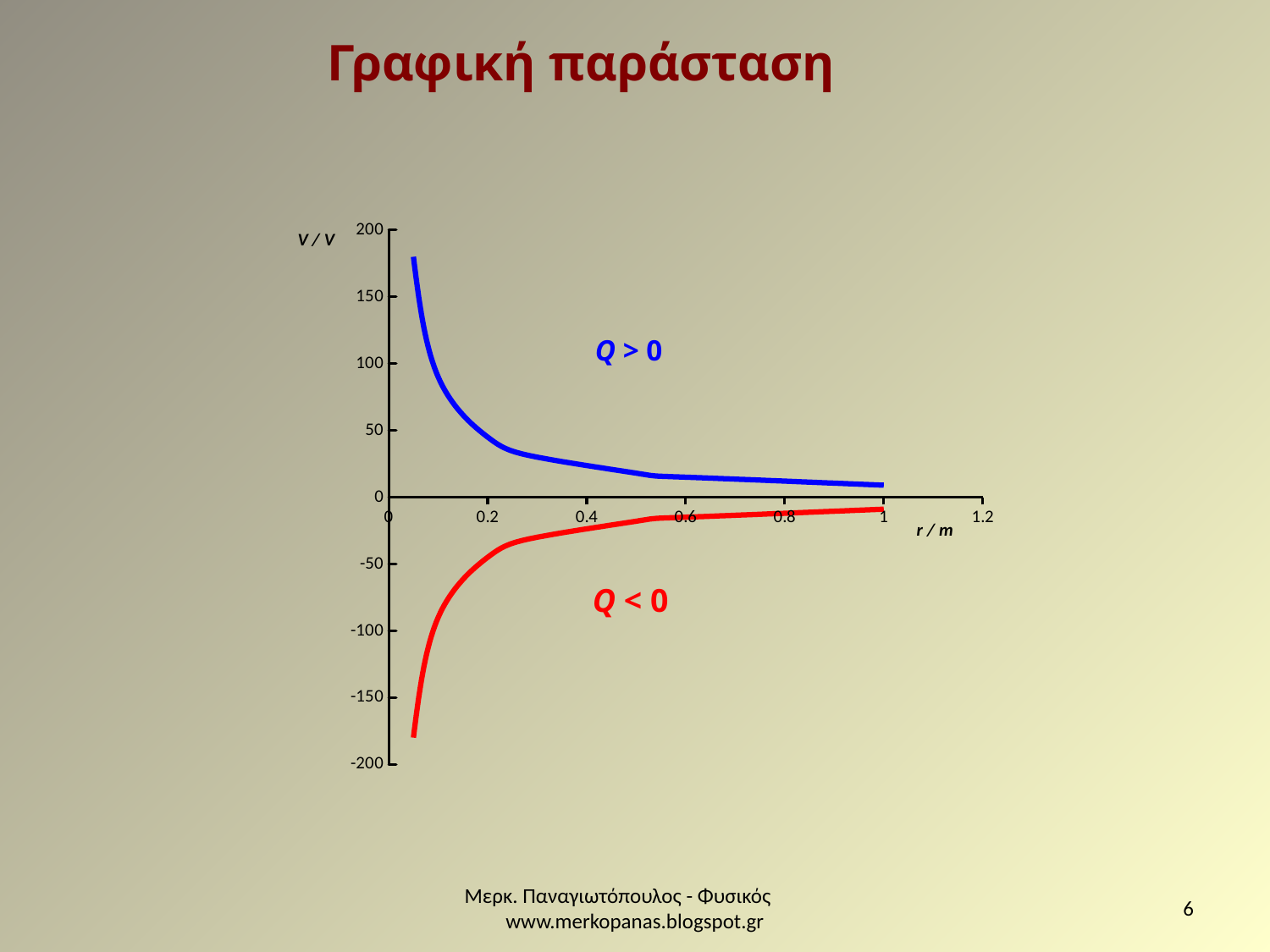
Which curve is labelled Q > 0, the blue one or the red one? blue Does the blue (Q > 0) curve rise or fall as r increases? fall Is the value of the blue (Q > 0) curve at r = 0.4 greater or less than 50? less What is the highest tick value shown on the vertical axis? 200 Is the value of the red (Q < 0) curve at r = 0.1 greater or less than -50? less Does the red (Q < 0) curve rise or fall as r increases? rise Is the value of the red (Q < 0) curve at r = 0.4 greater or less than -50? greater What kind of chart is shown on the slide? line chart What is the label of the horizontal axis? r / m How many curves are plotted on the chart? 2 At r = 0.4, which curve has the larger value, the blue (Q > 0) or the red (Q < 0)? blue (Q > 0)